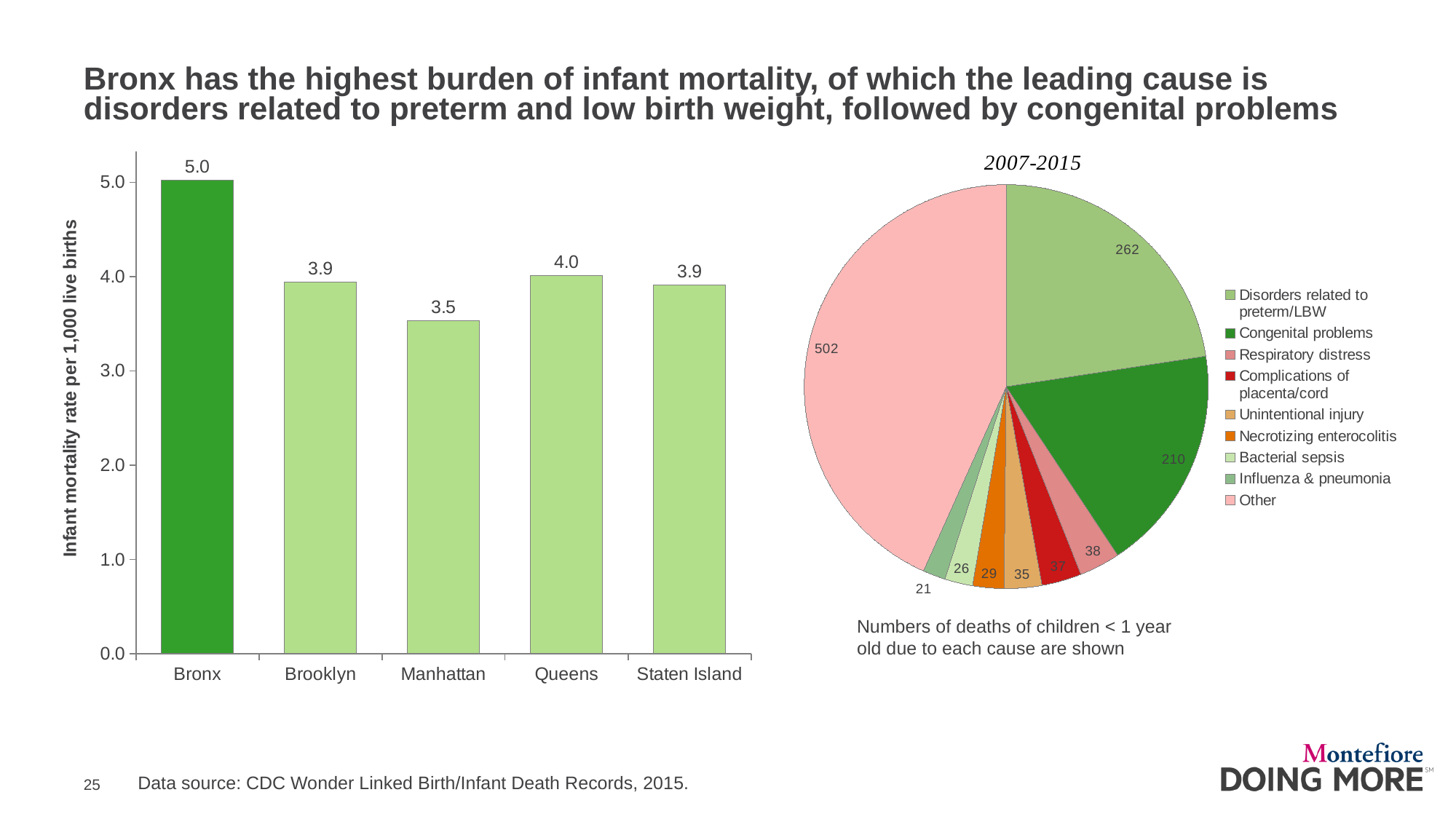
In the bar chart on the left, what is the infant mortality rate for Manhattan? 3.5 In the pie chart titled 2007-2015, how many deaths are attributed to congenital problems? 210 In the pie chart titled 2007-2015, how many causes does the legend list? 9 In the bar chart on the left, which borough has the highest infant mortality rate? Bronx In the pie chart titled 2007-2015, how many deaths are attributed to influenza & pneumonia? 21 In the bar chart on the left, which borough has the lowest infant mortality rate? Manhattan In the bar chart on the left, what is the infant mortality rate per 1,000 live births for the Bronx? 5.0 What type of chart is the chart on the left of the slide? Bar chart In the pie chart titled 2007-2015, how many more deaths are due to disorders related to preterm/LBW than to congenital problems? 52 In the pie chart titled 2007-2015, which cause has the largest slice? Other In the bar chart on the left, how many boroughs are shown? 5 In the bar chart on the left, what is the difference between the infant mortality rates of the Bronx and Manhattan? 1.5